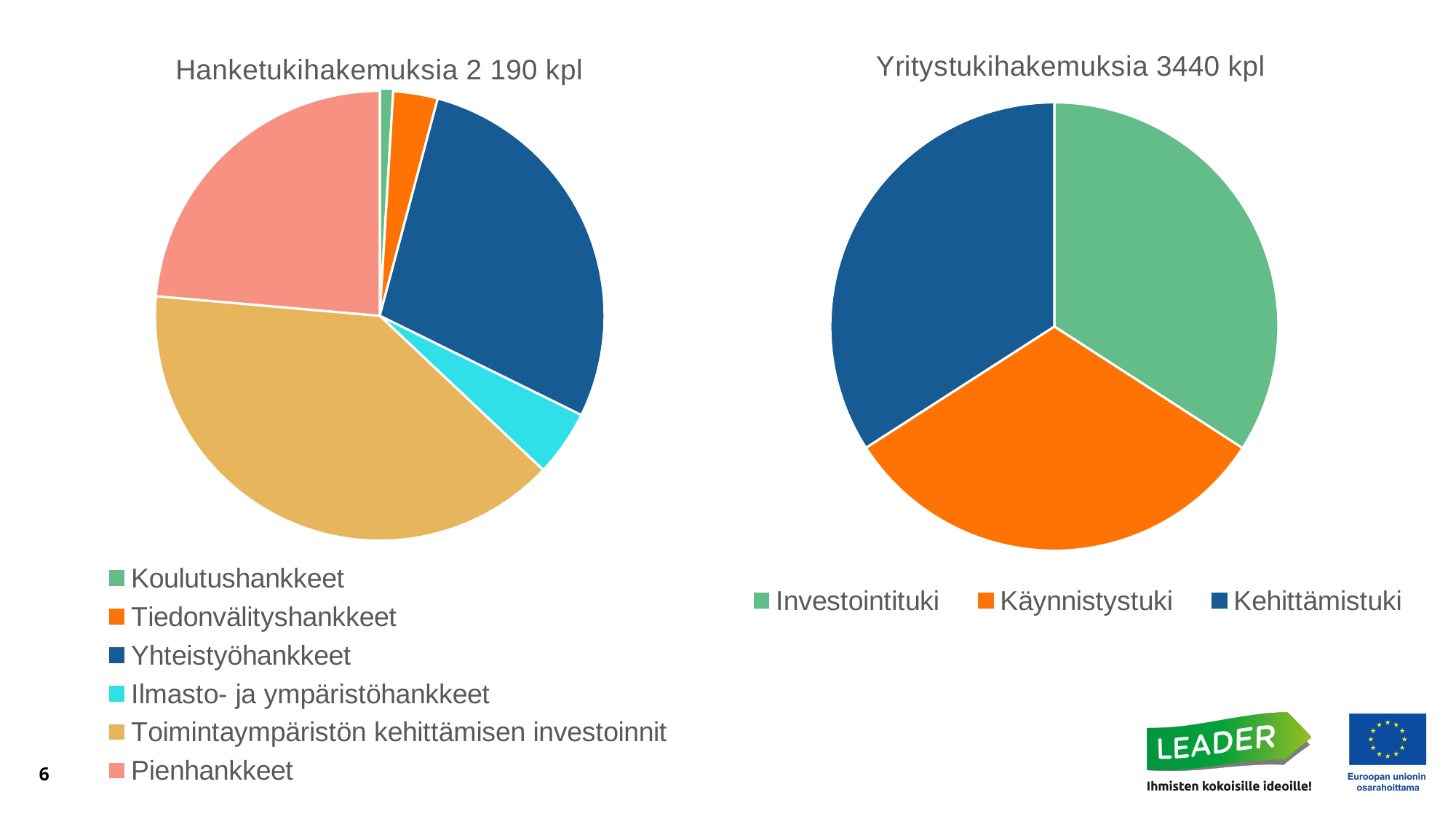
In the chart titled "Hanketukihakemuksia 2 190 kpl", which category has the largest slice? Toimintaympäristön kehittämisen investoinnit What is the title of the pie chart on the left of the slide? Hanketukihakemuksia 2 190 kpl In the chart titled "Hanketukihakemuksia 2 190 kpl", which is larger: Pienhankkeet or Tiedonvälityshankkeet? Pienhankkeet In the chart titled "Hanketukihakemuksia 2 190 kpl", how many slices does the pie have? 6 In the chart titled "Hanketukihakemuksia 2 190 kpl", which is larger: Yhteistyöhankkeet or Ilmasto- ja ympäristöhankkeet? Yhteistyöhankkeet In the chart titled "Hanketukihakemuksia 2 190 kpl", which is larger: Toimintaympäristön kehittämisen investoinnit or Yhteistyöhankkeet? Toimintaympäristön kehittämisen investoinnit How many entries does the legend of the chart titled "Yritystukihakemuksia 3440 kpl" list? 3 In the chart titled "Hanketukihakemuksia 2 190 kpl", which category has the smallest slice? Koulutushankkeet In the chart titled "Yritystukihakemuksia 3440 kpl", how many slices does the pie have? 3 What kind of chart is the chart titled "Yritystukihakemuksia 3440 kpl"? pie chart What kind of chart is the chart titled "Hanketukihakemuksia 2 190 kpl"? pie chart In the chart titled "Yritystukihakemuksia 3440 kpl", which category is shown in orange? Käynnistystuki